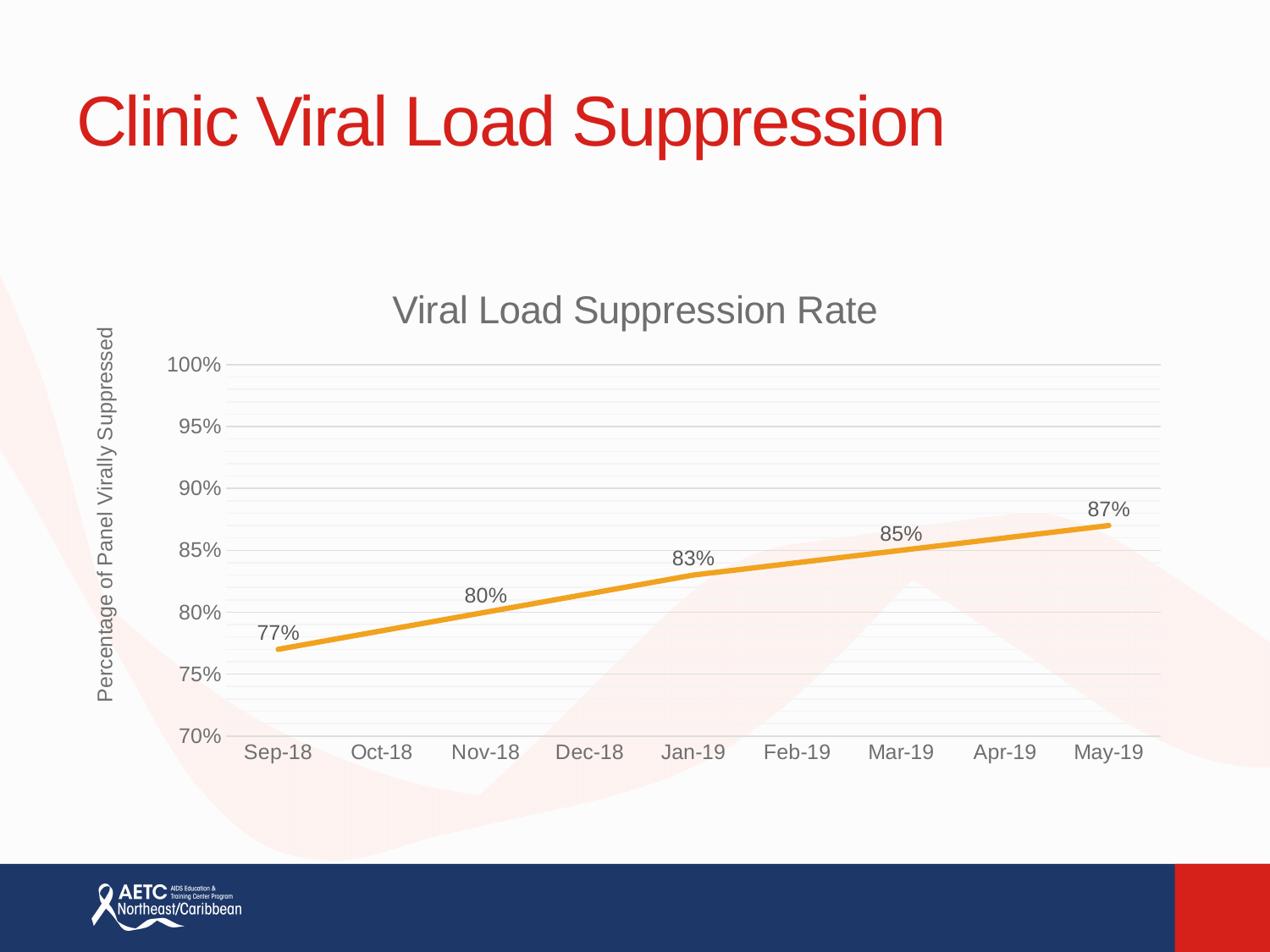
Does the viral load suppression rate rise or fall from Sep-18 to May-19? rise What is the viral load suppression rate for Mar-19? 85% Which is larger, the suppression rate in Jan-19 or in Nov-18? Jan-19 What is the viral load suppression rate for May-19? 87% Which month has the highest viral load suppression rate? May-19 What is the viral load suppression rate for Sep-18? 77% What kind of chart is shown on the slide? line chart Which month has the lowest viral load suppression rate? Sep-18 What is the viral load suppression rate for Jan-19? 83% What is the viral load suppression rate for Nov-18? 80% What is the difference between the suppression rate in May-19 and in Sep-18? 10% What is the title of the chart? Viral Load Suppression Rate